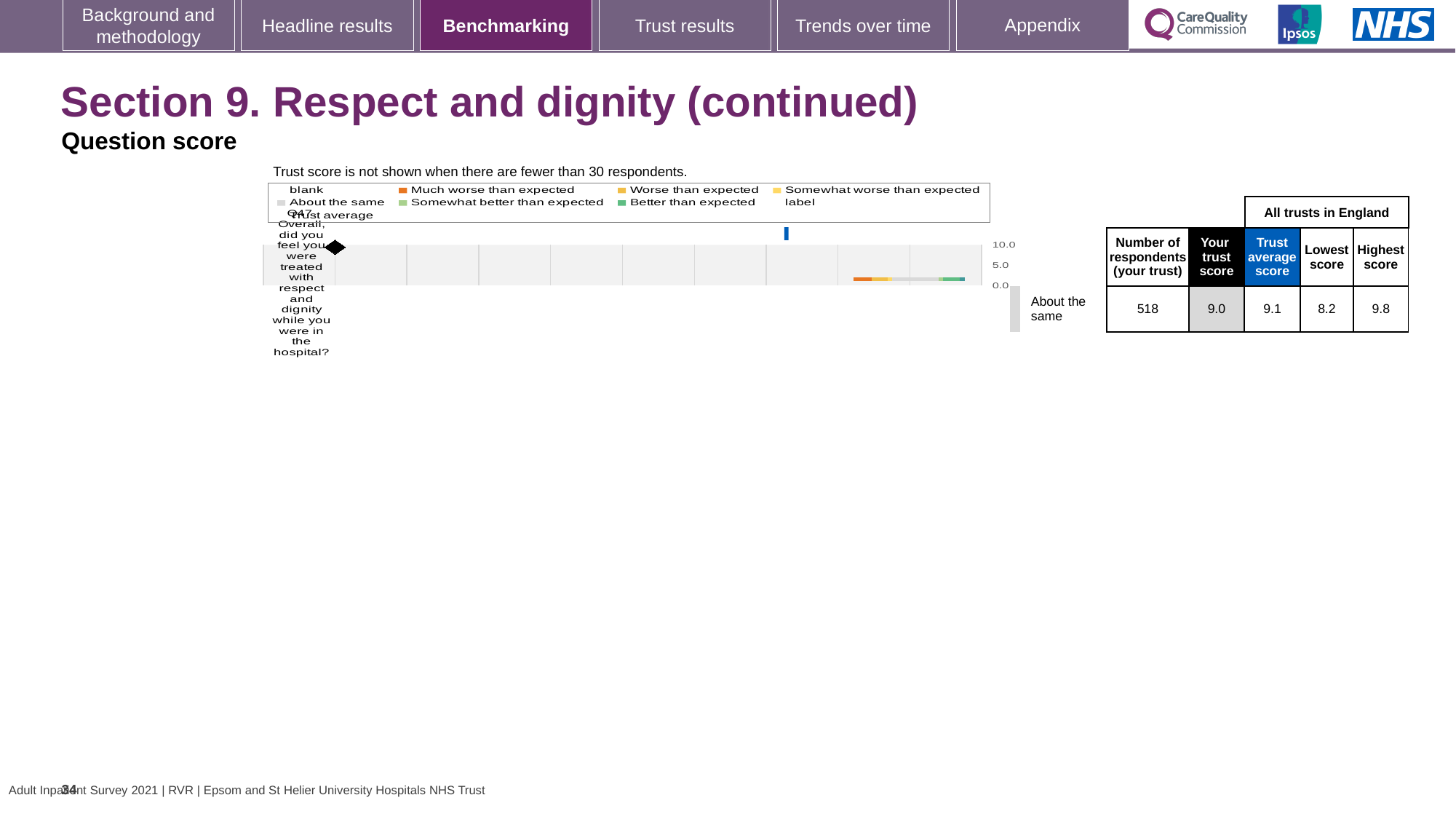
Which is larger for Q47: the trust's own score or the trust average score? Trust average score What is the highest score among all trusts in England for Q47? 9.8 What kind of chart is used to show the question score? Bar chart What is the trust score for Q47 shown in the table? 9.0 What is the lowest score among all trusts in England for Q47? 8.2 What is the difference between the trust average score and the trust's own score for Q47? 0.1 Is the trust score for Q47 greater or less than 5.0 on the chart axis? greater Which benchmark category is the trust's Q47 score placed in? About the same What is the difference between the highest and lowest scores for Q47 across all trusts in England? 1.6 How many questions are plotted on the chart? 1 What is the trust average score for Q47 across all trusts in England? 9.1 How many respondents from the trust answered Q47? 518